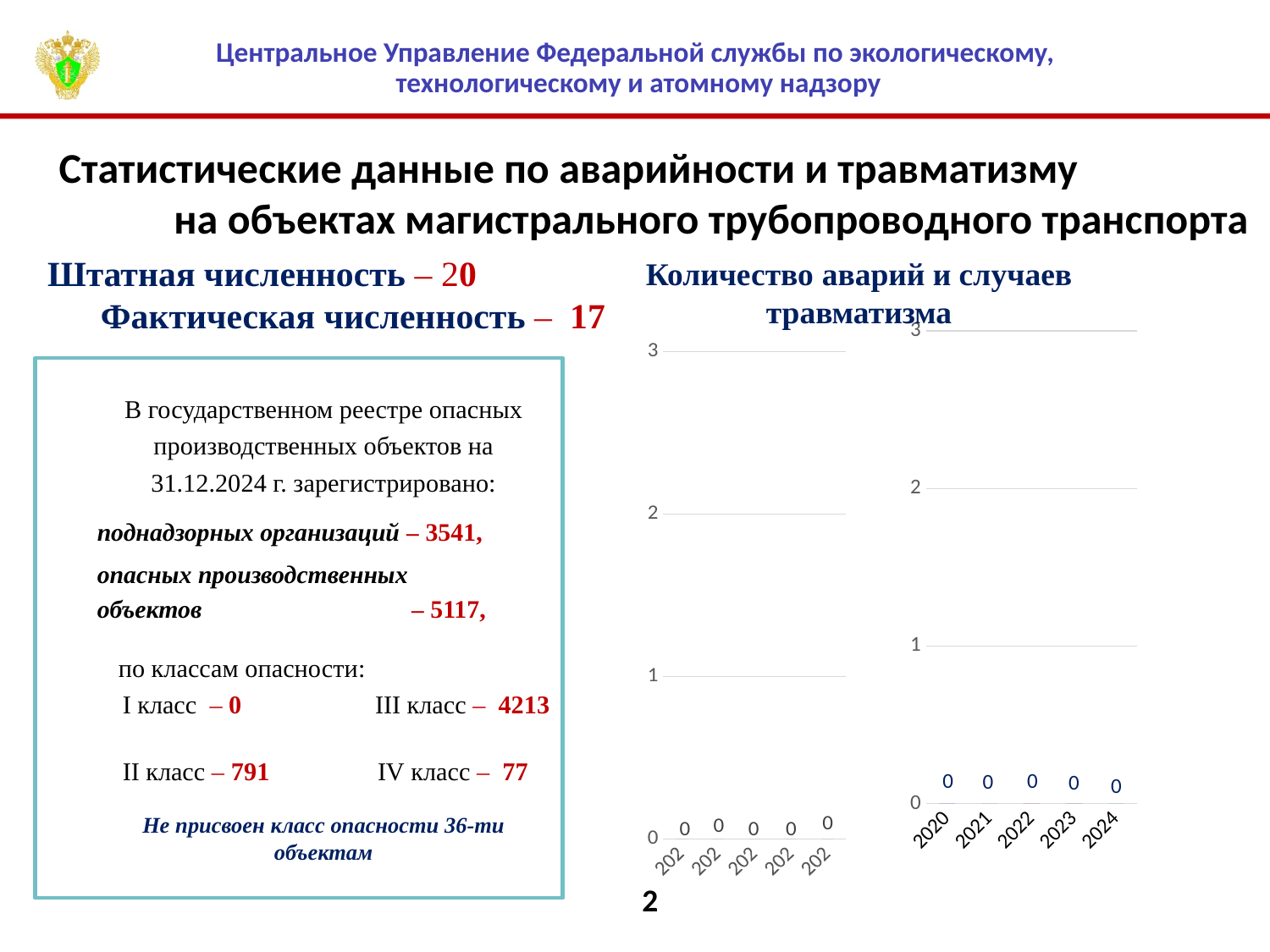
How many categories are shown on the right-hand chart (with years 2020–2024)? 5 On the right-hand chart (with years 2020–2024), what is the value for 2020? 0 On the right-hand chart (with years 2020–2024), what is the difference between the values for 2023 and 2021? 0 What is the highest tick value on the vertical axis of the left-hand chart under 'Количество аварий и случаев травматизма'? 3 What is the title shown above the charts on the right side of the slide? Количество аварий и случаев травматизма On the right-hand chart (with years 2020–2024), what is the total of the values across all five years? 0 How many data points are shown on the left-hand chart under 'Количество аварий и случаев травматизма'? 5 On the right-hand chart (with years 2020–2024), what is the value for 2024? 0 On the right-hand chart (with years 2020–2024), what is the value for 2022? 0 On the right-hand chart (with years 2020–2024), is the value for 2022 greater or less than 1? less On the right-hand chart (with years 2020–2024), do the values rise, fall or stay the same from 2020 to 2024? stay the same On the left-hand chart under 'Количество аварий и случаев травматизма', what is the data label on the first point? 0